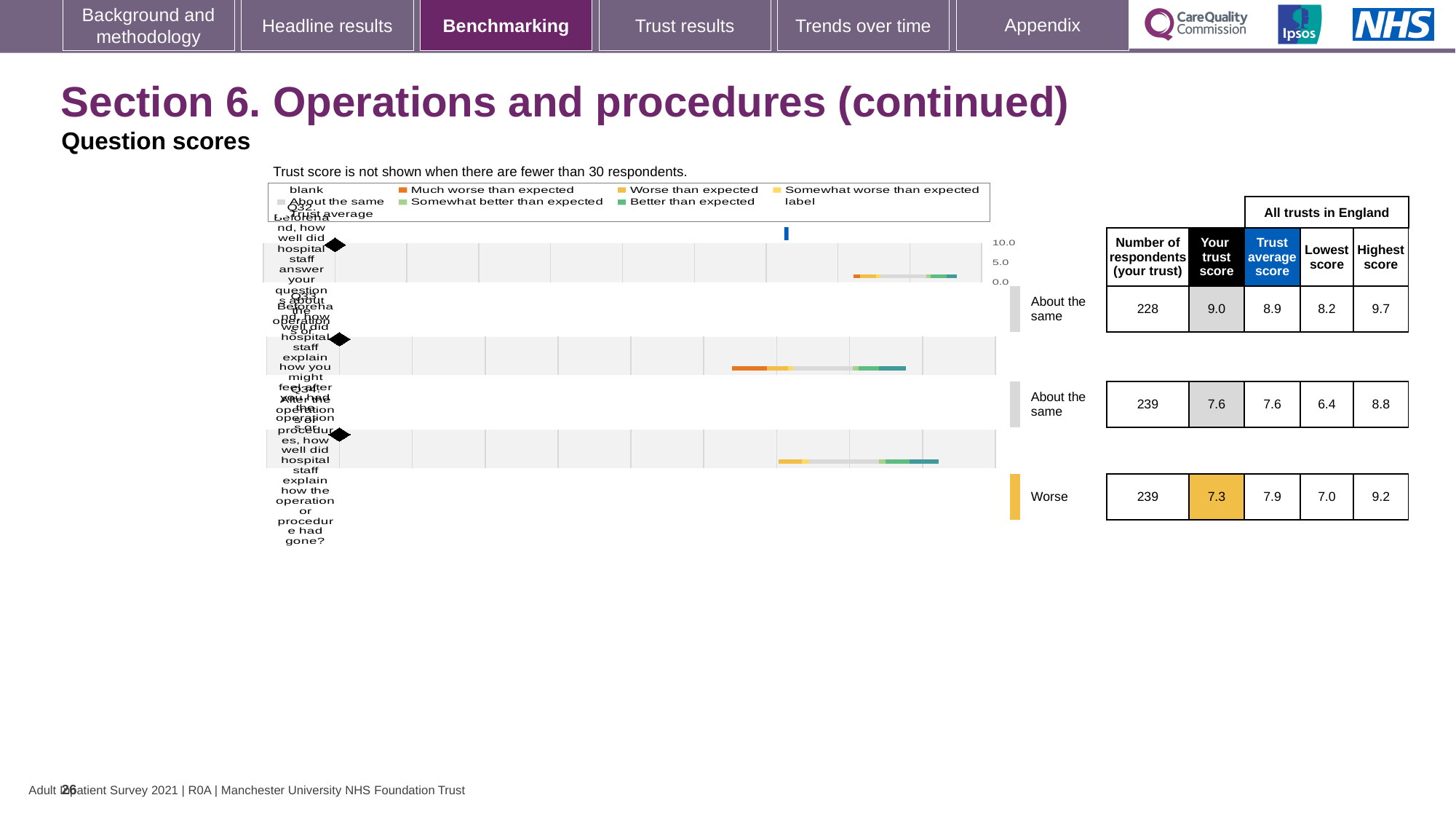
Which question has the lowest 'Highest score' across all trusts in England? Q33 (8.8) What is the number of respondents for the first question (Q32)? 228 How many questions (rows) are plotted in the chart? 3 What kind of chart is shown on the slide? bar chart What benchmark category label is shown for the third question (Q34)? Worse For the third question (Q34), which is larger: the trust's own score or the trust average score? Trust average score (7.9) Is the trust score marker for the first question (Q32) greater or less than 5.0 on the axis? greater What is the 'Trust average score' for the third question (Q34)? 7.9 What is the difference between the highest score and the lowest score for the third question (Q34)? 2.2 What is the 'Your trust score' for the first question (Q32)? 9.0 What is the 'Lowest score' for the second question (Q33)? 6.4 Which question has the highest 'Your trust score'? Q32 (9.0)